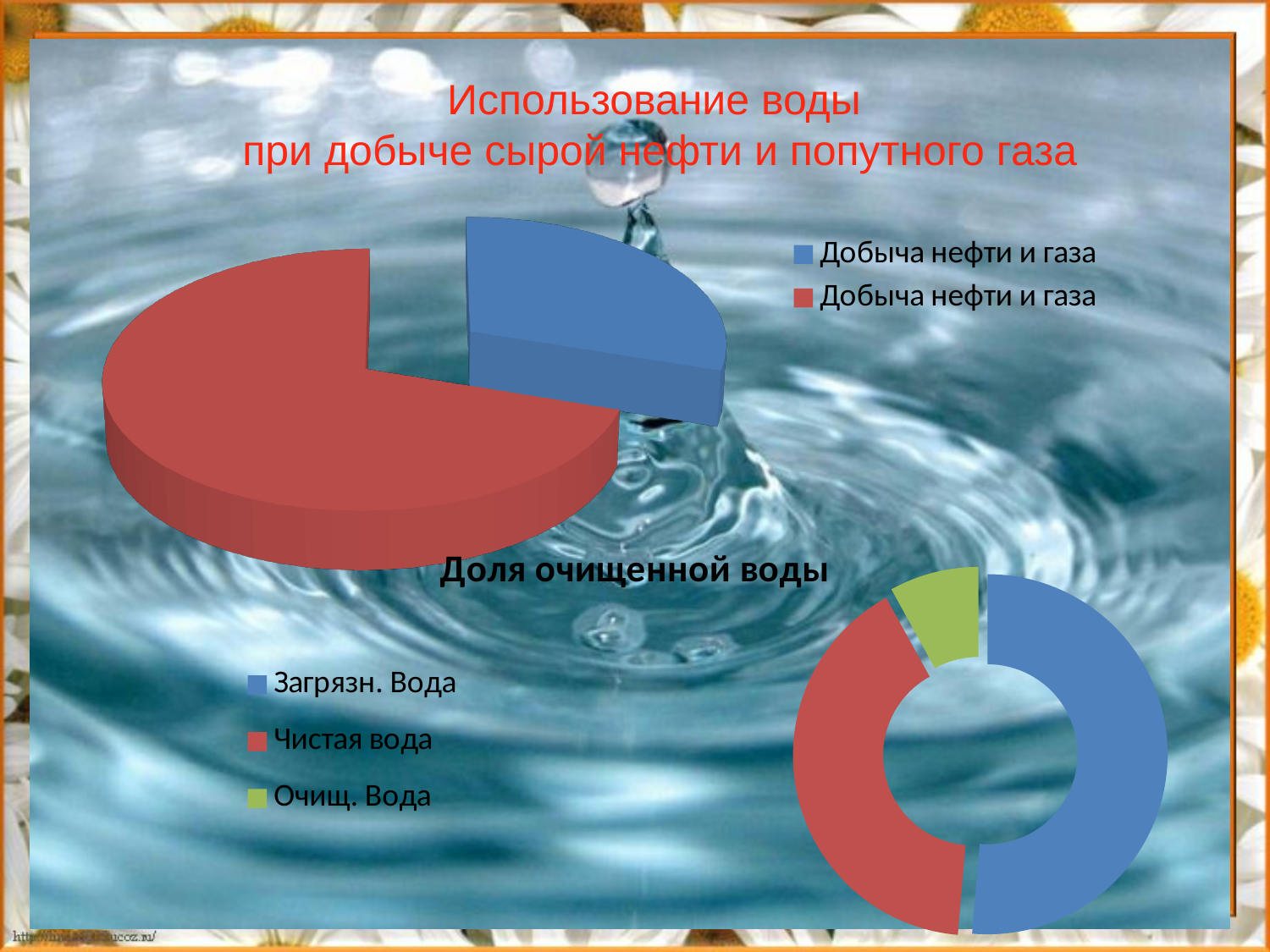
In the chart "Доля очищенной воды", what colour represents Очищ. Вода? green How many categories does the lower chart "Доля очищенной воды" show? 3 How many entries does the legend of the upper pie chart list? 2 In the chart "Доля очищенной воды", which is larger, Загрязн. Вода or Очищ. Вода? Загрязн. Вода What is the title of the lower chart on the slide? Доля очищенной воды In the chart "Доля очищенной воды", which category has the smallest share? Очищ. Вода In the chart "Доля очищенной воды", which is larger, Чистая вода or Очищ. Вода? Чистая вода How many slices does the upper pie chart have? 2 In the chart "Доля очищенной воды", which category has the largest share? Загрязн. Вода In the upper pie chart, which slice is larger, the red one or the blue one? the red one What kind of chart is the lower chart titled "Доля очищенной воды"? doughnut chart What kind of chart is the upper chart on the slide? pie chart